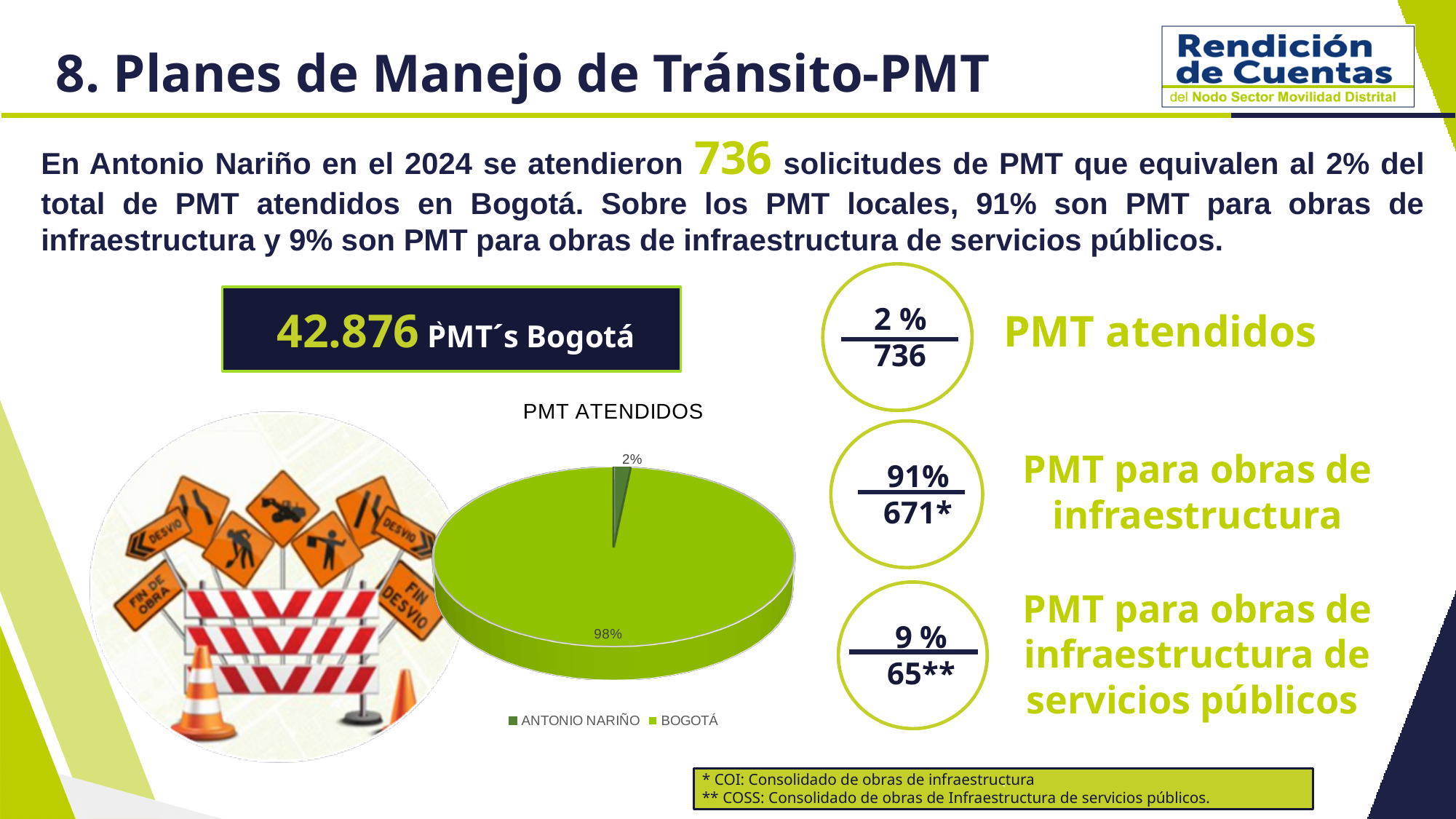
What is the difference in percentage points between the BOGOTÁ slice and the ANTONIO NARIÑO slice? 96 What share of the pie chart does ANTONIO NARIÑO represent? 2% Which slice of the pie chart is the smallest? ANTONIO NARIÑO Which slice of the pie chart is the largest? BOGOTÁ What is the title of the pie chart? PMT ATENDIDOS How many entries does the legend of the pie chart list? 2 What share of the pie chart does BOGOTÁ represent? 98% Which is larger in the pie chart, ANTONIO NARIÑO or BOGOTÁ? BOGOTÁ How many slices does the pie chart have? 2 What kind of chart is shown on the slide? pie chart Which legend entry is shown in dark green in the pie chart? ANTONIO NARIÑO